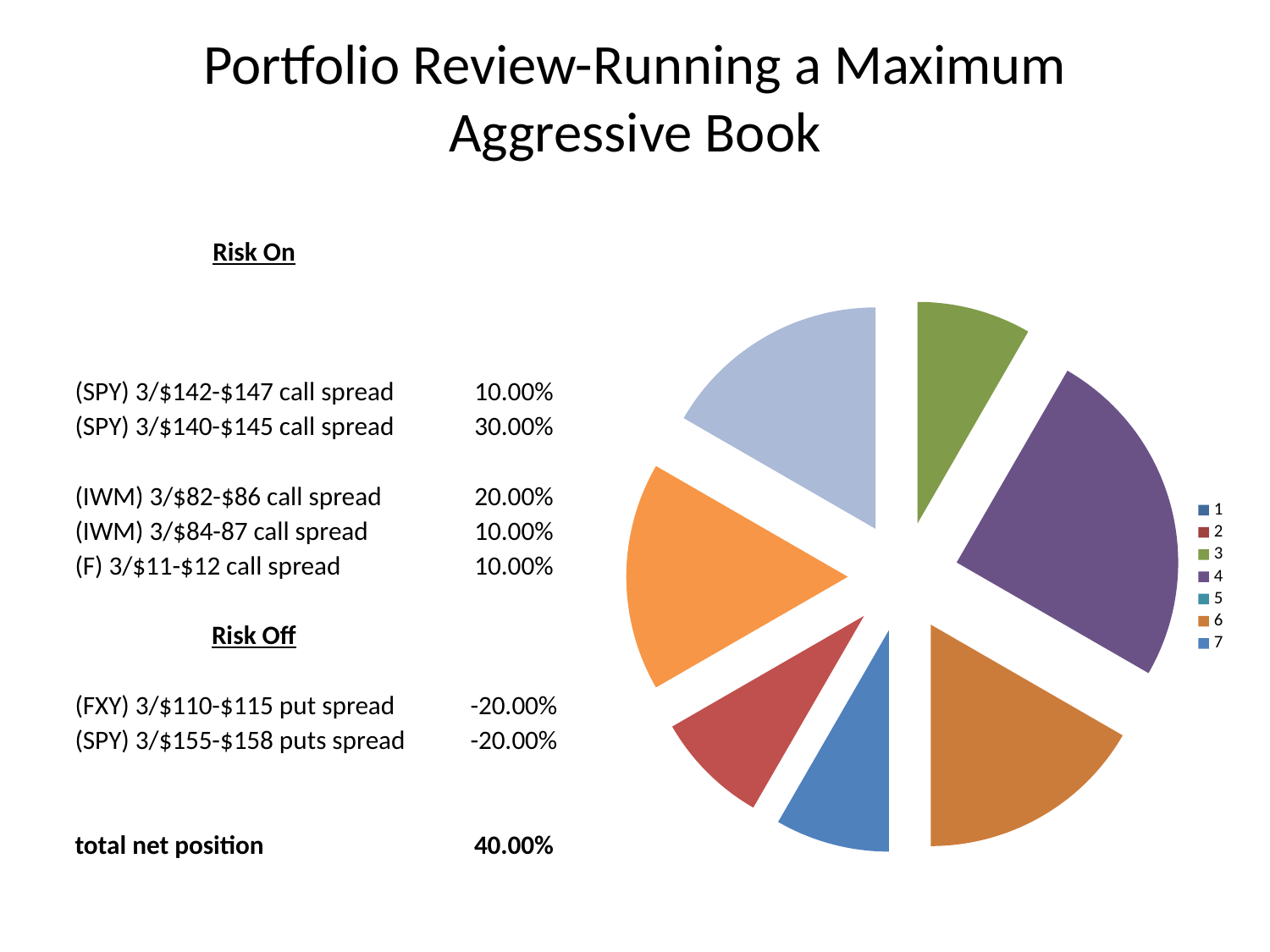
In the pie chart, which slice is larger, category 4 or category 3? 4 In the pie chart, which slice is larger, category 4 or category 6? 4 What colour is the slice for category 4 in the pie chart? purple In the pie chart, which slice is larger, category 6 or category 1? 6 Which legend category has the largest slice in the pie chart? 4 How many slices does the pie chart have? 7 What kind of chart is shown on the slide? pie chart How many entries does the pie chart's legend list? 7 What are the labels listed in the pie chart's legend? 1, 2, 3, 4, 5, 6, 7